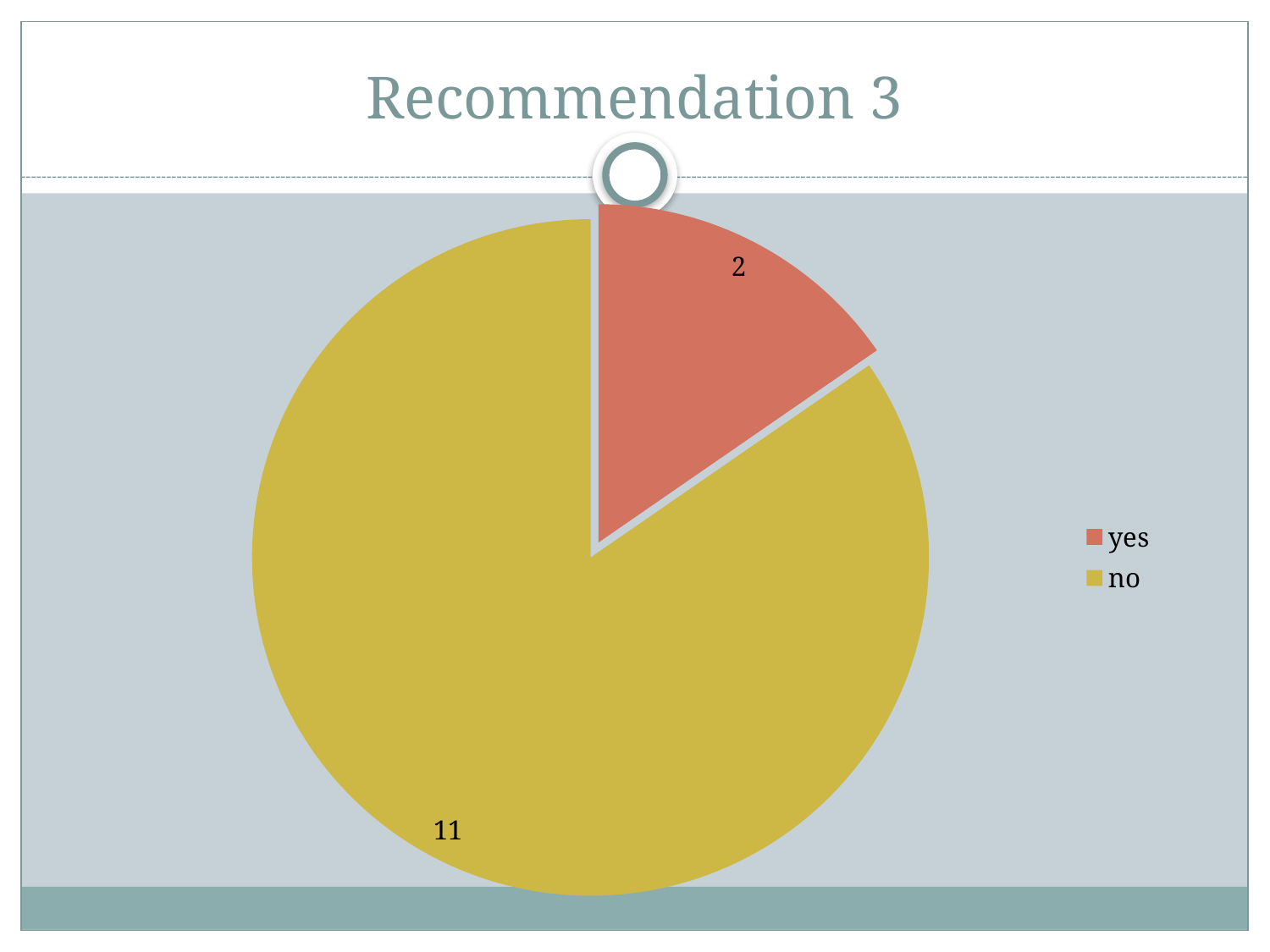
What kind of chart is shown on the slide? pie chart Which category has the largest slice? no What is the value for "no"? 11 What is the total of all slices in the pie chart? 13 Which category has the smallest slice? yes How many categories does the pie chart show? 2 Which is larger, the value for "yes" or the value for "no"? no What is the difference between the values for "no" and "yes"? 9 What colour is the "no" slice? yellow What is the title of the slide containing the chart? Recommendation 3 What is the value for "yes"? 2